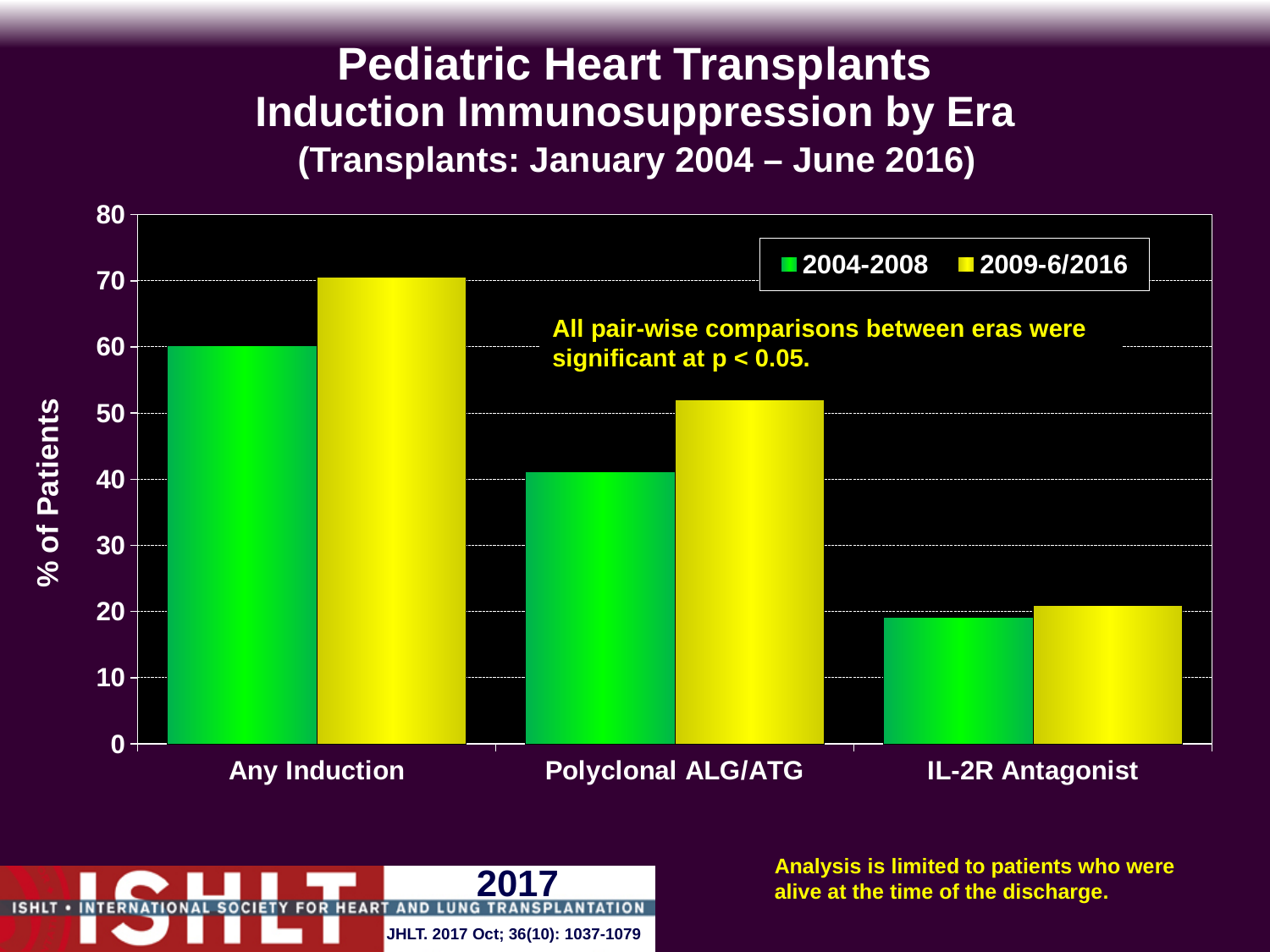
Is the value for IL-2R Antagonist in 2004-2008 greater or less than 30? less Is the value for Polyclonal ALG/ATG in 2009-6/2016 greater or less than 40? greater What kind of chart is shown on the slide? bar chart Is the value for Any Induction in 2009-6/2016 greater or less than 60? greater For Polyclonal ALG/ATG, which era has the larger value, 2004-2008 or 2009-6/2016? 2009-6/2016 Which category has the lowest value for the 2004-2008 series? IL-2R Antagonist Which colour represents the 2004-2008 series in the legend? green Which category has the highest value for the 2009-6/2016 series? Any Induction How many categories are shown on the x axis? 3 How many series does the legend list? 2 What is the label of the y axis? % of Patients